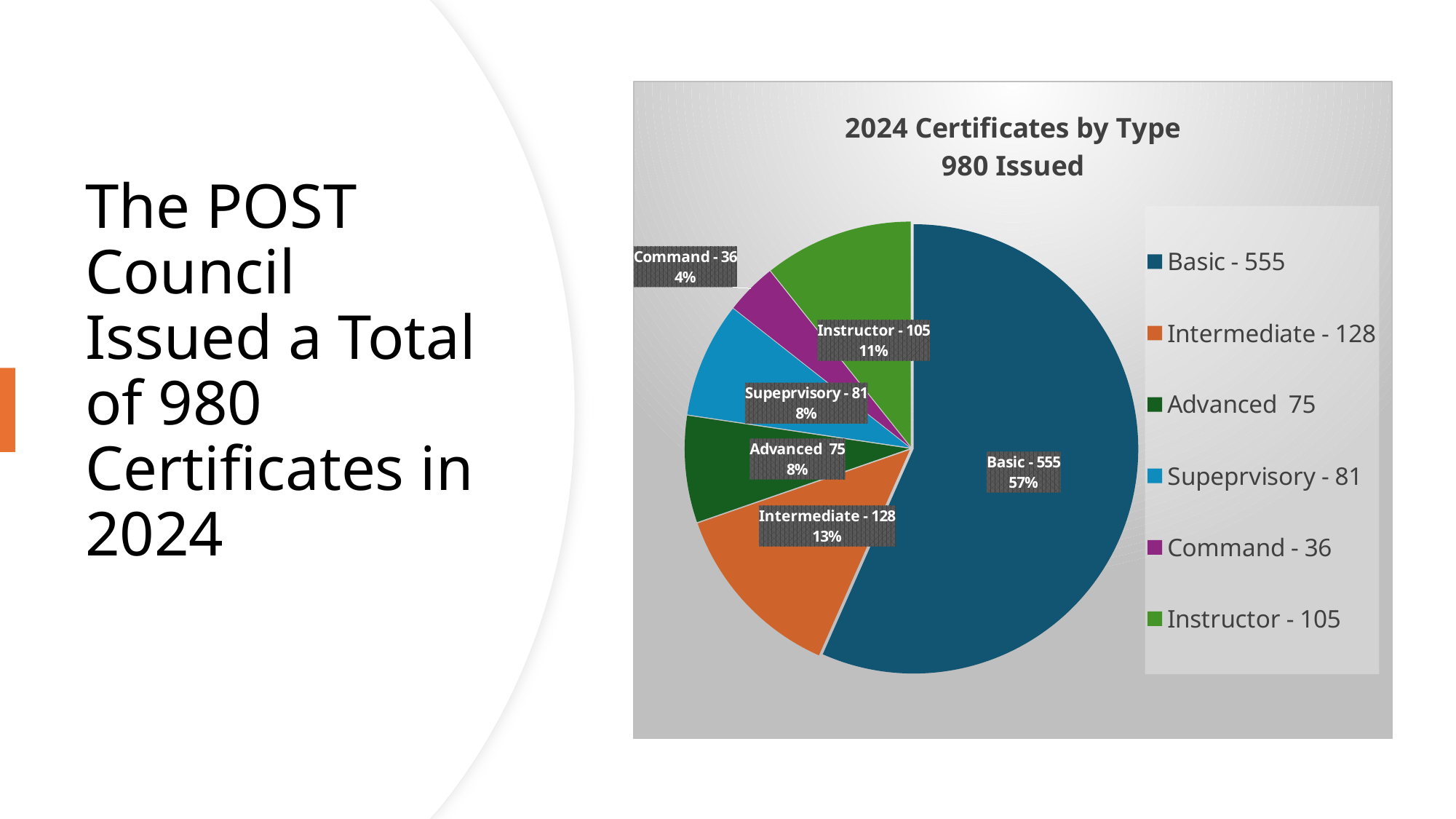
Which certificate type has the smallest slice? Command What percentage of the pie does the Command slice represent? 4% What is the title of the chart? 2024 Certificates by Type 980 Issued Which certificate type has the largest slice? Basic What colour is the Advanced slice? dark green How many Intermediate certificates were issued? 128 What percentage of the pie does the Basic slice represent? 57% What is the difference between the number of Basic and Intermediate certificates? 427 Which is larger, the Instructor slice or the Supervisory slice? Instructor How many slices does the pie chart have? 6 What percentage of the pie does the Instructor slice represent? 11% What kind of chart is shown on the slide? pie chart